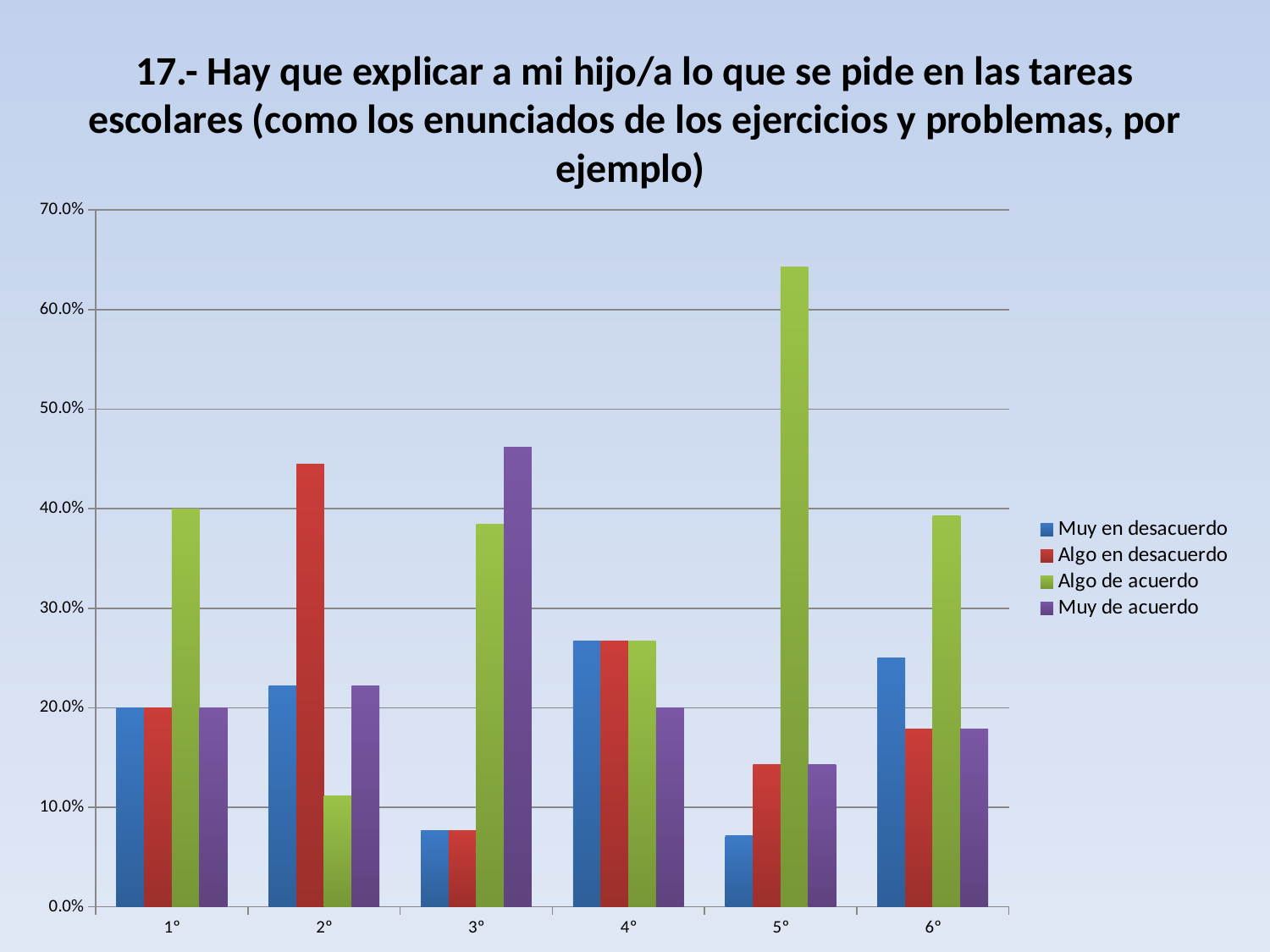
How many series does the legend list? 4 What kind of chart is shown on the slide? bar chart How many categories are shown on the x axis? 6 Which category has the highest value for Algo de acuerdo? 5° Is the value for Muy en desacuerdo in category 5° greater or less than 10.0%? less What is the value for Algo de acuerdo in category 1°? 40.0% Is the value for Algo de acuerdo in category 5° greater or less than 60.0%? greater Is the value for Algo en desacuerdo in category 2° greater or less than 40.0%? greater What is the value for Muy en desacuerdo in category 1°? 20.0% Which category has the lowest value for Algo de acuerdo? 2° Which is larger in category 3°: Muy de acuerdo or Algo de acuerdo? Muy de acuerdo Which series is shown in green in the legend? Algo de acuerdo